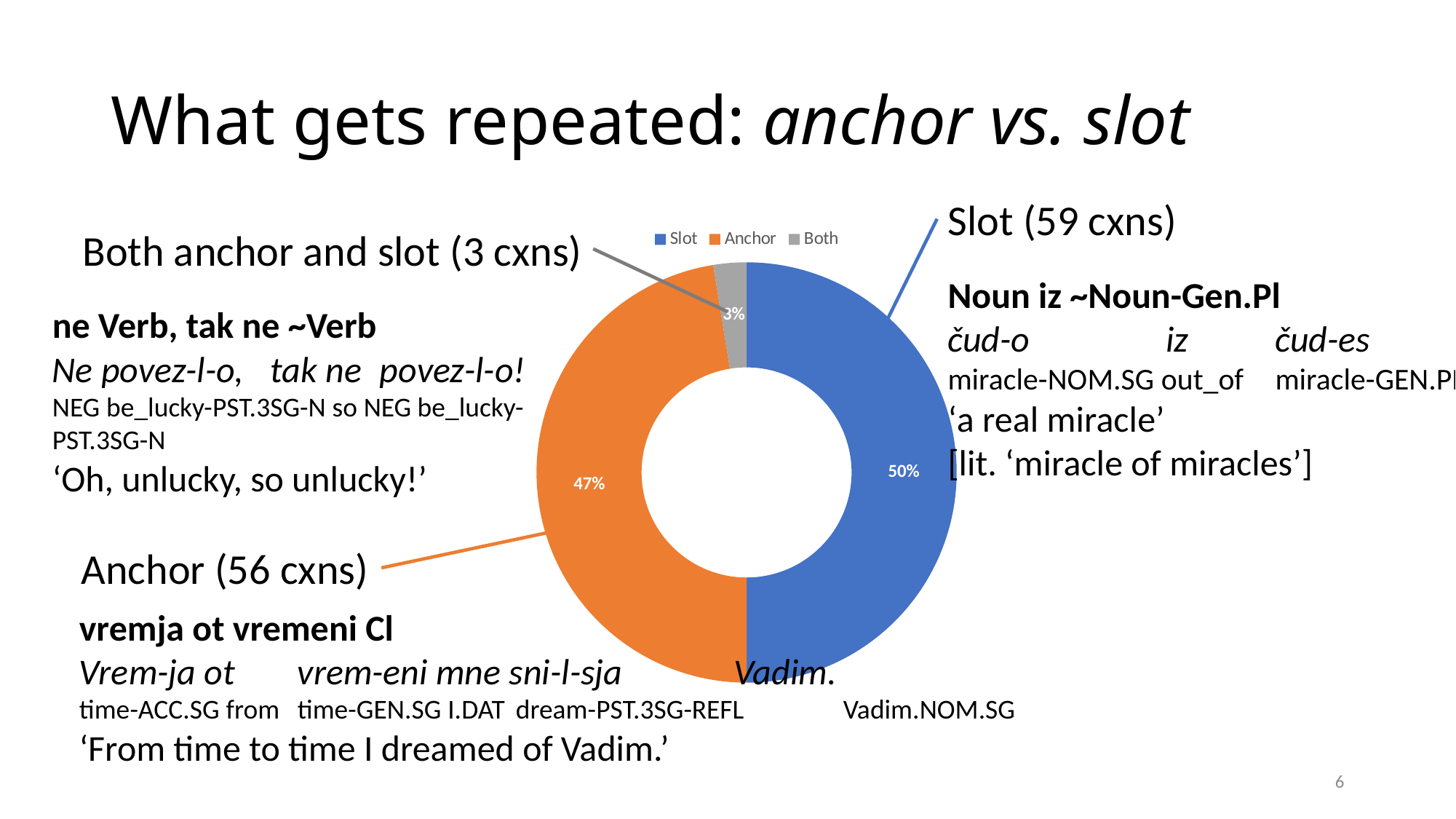
Which category has the smallest slice in the chart? Both What percentage of the chart does the Anchor slice represent? 47% What percentage of the chart does the Both slice represent? 3% According to the annotation, how many constructions (cxns) are in the Anchor category? 56 cxns Which slice is larger, Slot or Anchor? Slot How many slices does the chart have? 3 What colour is the Anchor slice in the chart? orange What kind of chart is shown on the slide? doughnut chart What is the difference in percentage points between the Slot slice and the Anchor slice? 3% What percentage of the chart does the Slot slice represent? 50% Which category has the largest slice in the chart? Slot How many entries does the chart legend list? 3